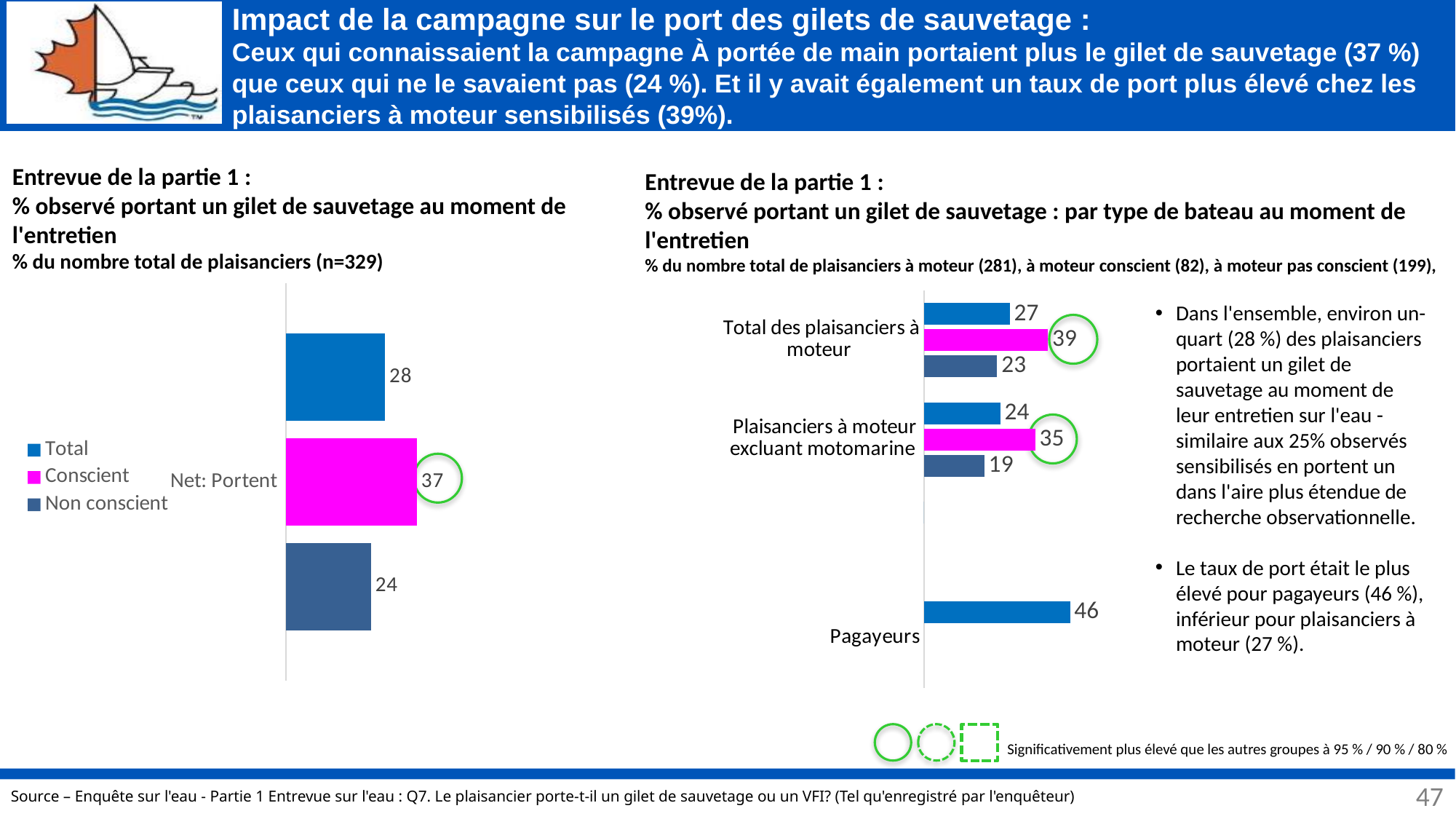
What kind of chart is the left chart? Bar chart How many series does the legend of the left chart list? 3 In the right chart, what is the Conscient value for Total des plaisanciers à moteur? 39 In the left chart, what is the value for the Non conscient series? 24 In the right chart, what is the Non conscient value for Plaisanciers à moteur excluant motomarine? 19 How many categories are shown on the right chart? 3 In the right chart, what is the value for Pagayeurs? 46 In the left chart, what is the difference between the Conscient and Non conscient values? 13 In the right chart, is the Total value for Total des plaisanciers à moteur larger or smaller than the Total value for Plaisanciers à moteur excluant motomarine? Larger In the right chart, which category has the highest Total value? Pagayeurs In the left chart, what is the value for the Conscient series for Net: Portent? 37 In the left chart, which series has the highest value? Conscient